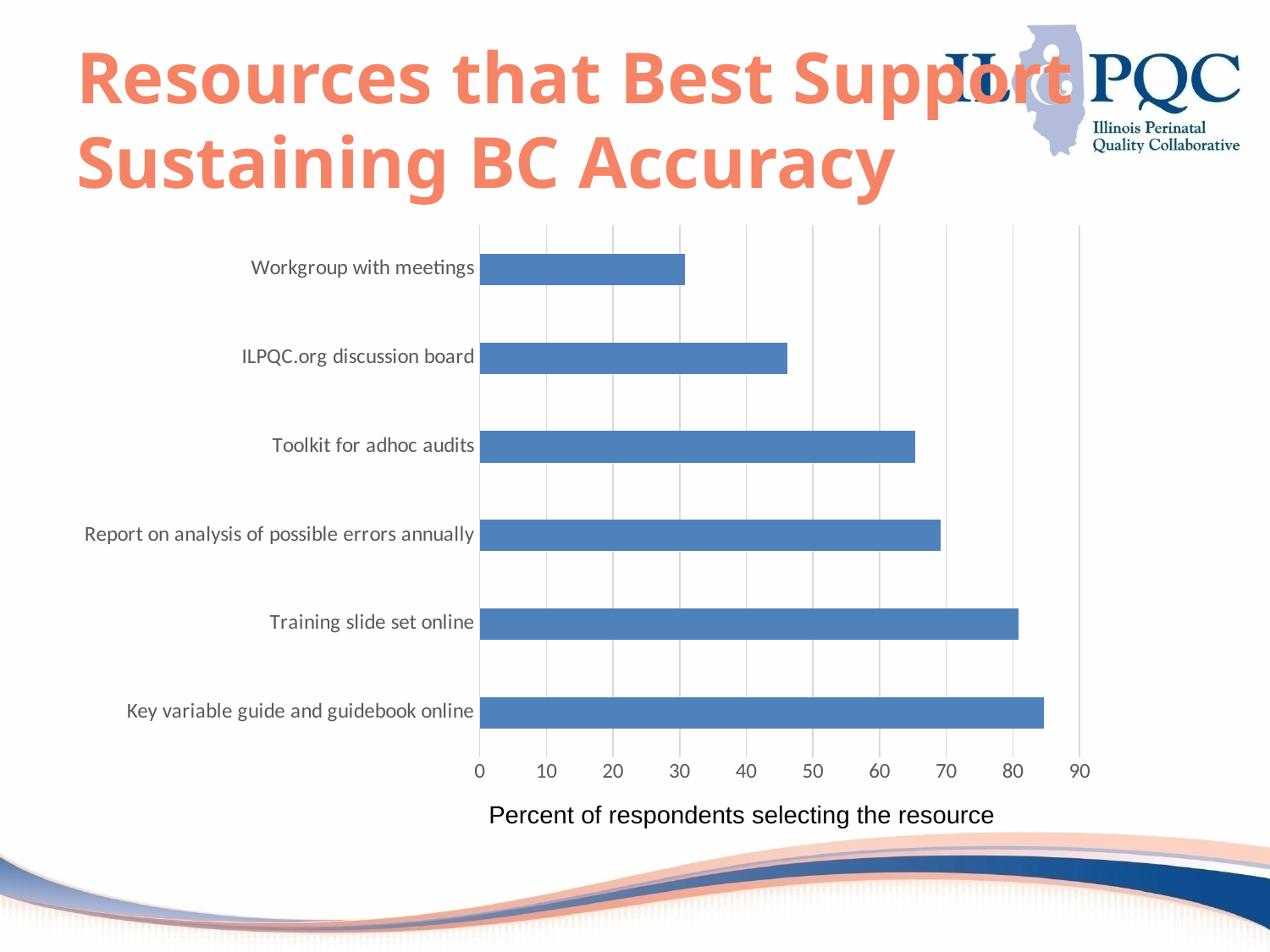
Is the value for ILPQC.org discussion board greater or less than 50? less Which has a larger value: ILPQC.org discussion board or Toolkit for adhoc audits? Toolkit for adhoc audits Is the value for Workgroup with meetings greater or less than 40? less What is the label of the horizontal axis of the chart? Percent of respondents selecting the resource Which resource has the lowest percent of respondents selecting it? Workgroup with meetings Is the value for Key variable guide and guidebook online greater or less than 80? greater What kind of chart is shown on the slide? bar chart Which resource has the highest percent of respondents selecting it? Key variable guide and guidebook online Which has a larger value: Training slide set online or Report on analysis of possible errors annually? Training slide set online How many resources (categories) are plotted in the chart? 6